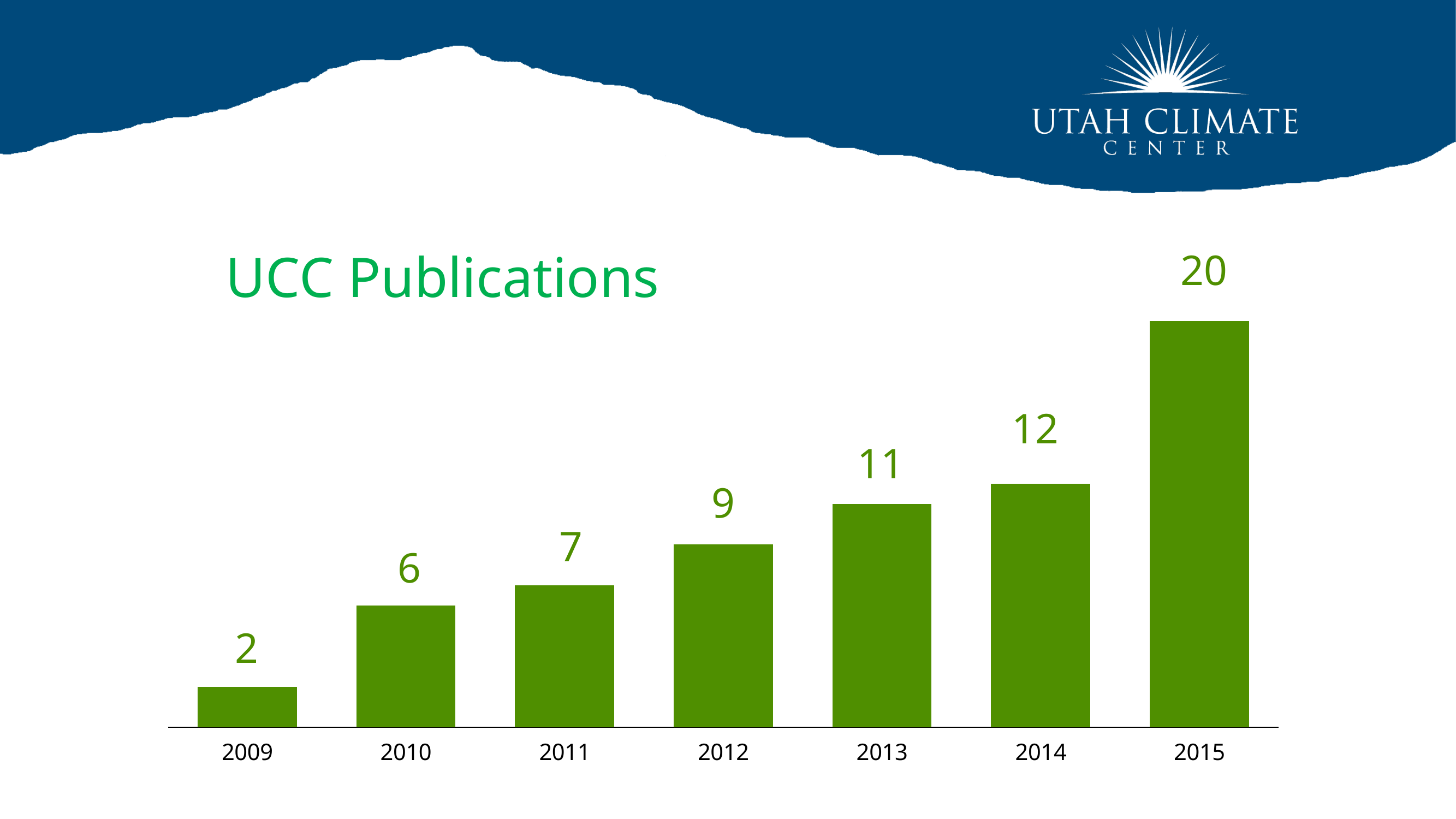
What is the difference between the values for 2013 and 2009? 9 What is the difference between the values for 2015 and 2014? 8 What is the value for 2014 in the UCC Publications chart? 12 What is the title of the chart? UCC Publications Which year has the lowest number of UCC publications? 2009 How many years are shown on the x axis of the chart? 7 What kind of chart is shown on the slide? bar chart What is the value for 2012 in the UCC Publications chart? 9 Which is larger, the value for 2011 or the value for 2013? 2013 Which year has the highest number of UCC publications? 2015 Do the values rise or fall from 2009 to 2015? rise What is the value for 2009 in the UCC Publications chart? 2